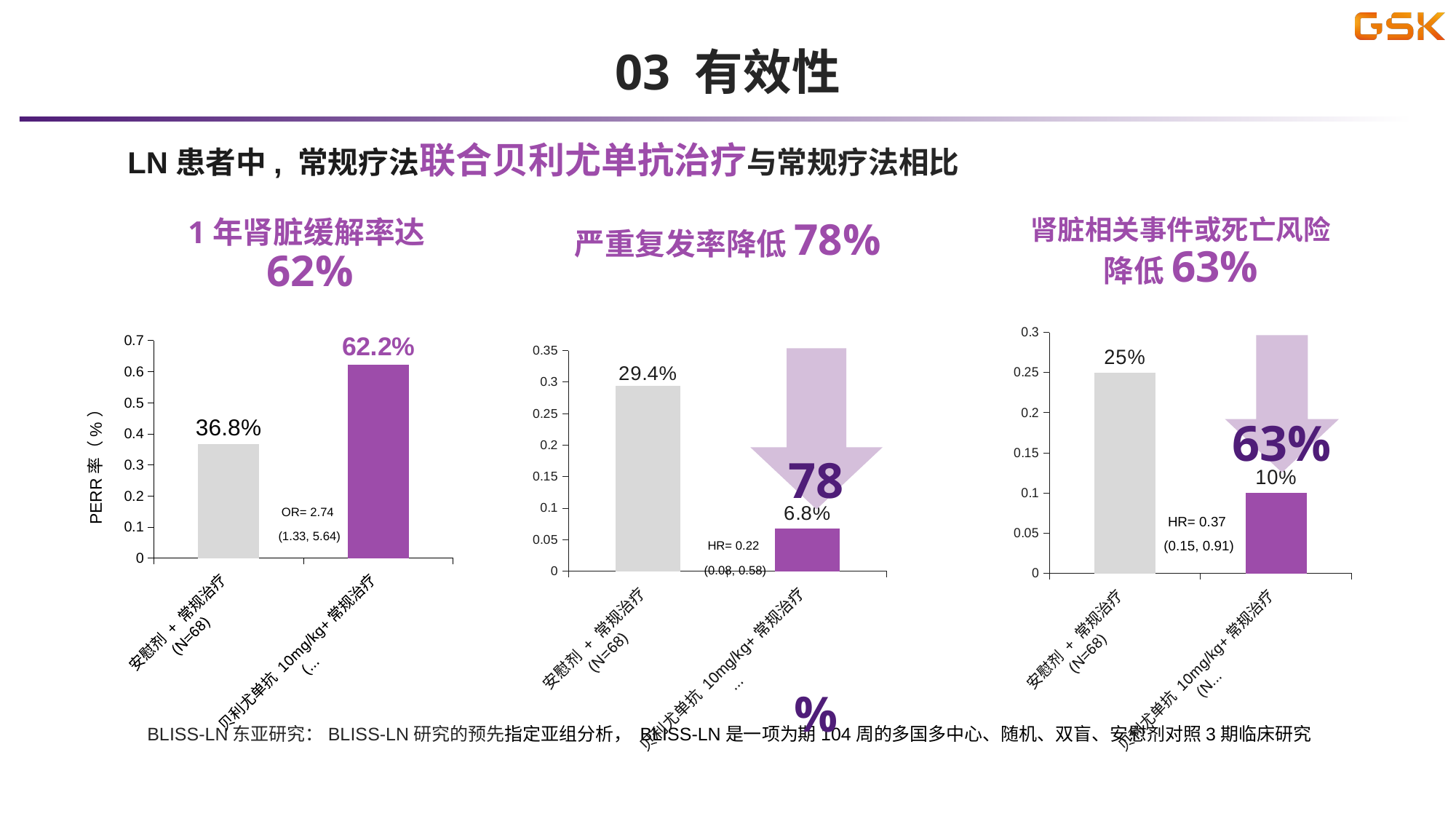
In the middle chart (严重复发率), what is the value for 安慰剂＋常规治疗 (N=68)? 29.4% In the left chart (1年肾脏缓解率), what is the PERR rate for 安慰剂＋常规治疗 (N=68)? 36.8% In the left chart (1年肾脏缓解率), what is the difference in PERR rate between the belimumab group and the placebo group? 25.4% How many bars does the middle chart (严重复发率) show? 2 In the right chart (肾脏相关事件或死亡风险), what is the value for 安慰剂＋常规治疗 (N=68)? 25% In the right chart (肾脏相关事件或死亡风险), what is the value for 贝利尤单抗 10mg/kg+常规治疗? 10% In the right chart (肾脏相关事件或死亡风险), what is the difference between the placebo group and the belimumab group? 15% In the left chart (1年肾脏缓解率), what is the PERR rate for 贝利尤单抗 10mg/kg+常规治疗? 62.2% In the middle chart (严重复发率), which group has the lower value? 贝利尤单抗 10mg/kg+常规治疗 In the middle chart (严重复发率), what is the value for 贝利尤单抗 10mg/kg+常规治疗? 6.8% In the left chart (1年肾脏缓解率), which group has the higher PERR rate? 贝利尤单抗 10mg/kg+常规治疗 What type of chart is the left chart (1年肾脏缓解率)? Bar chart